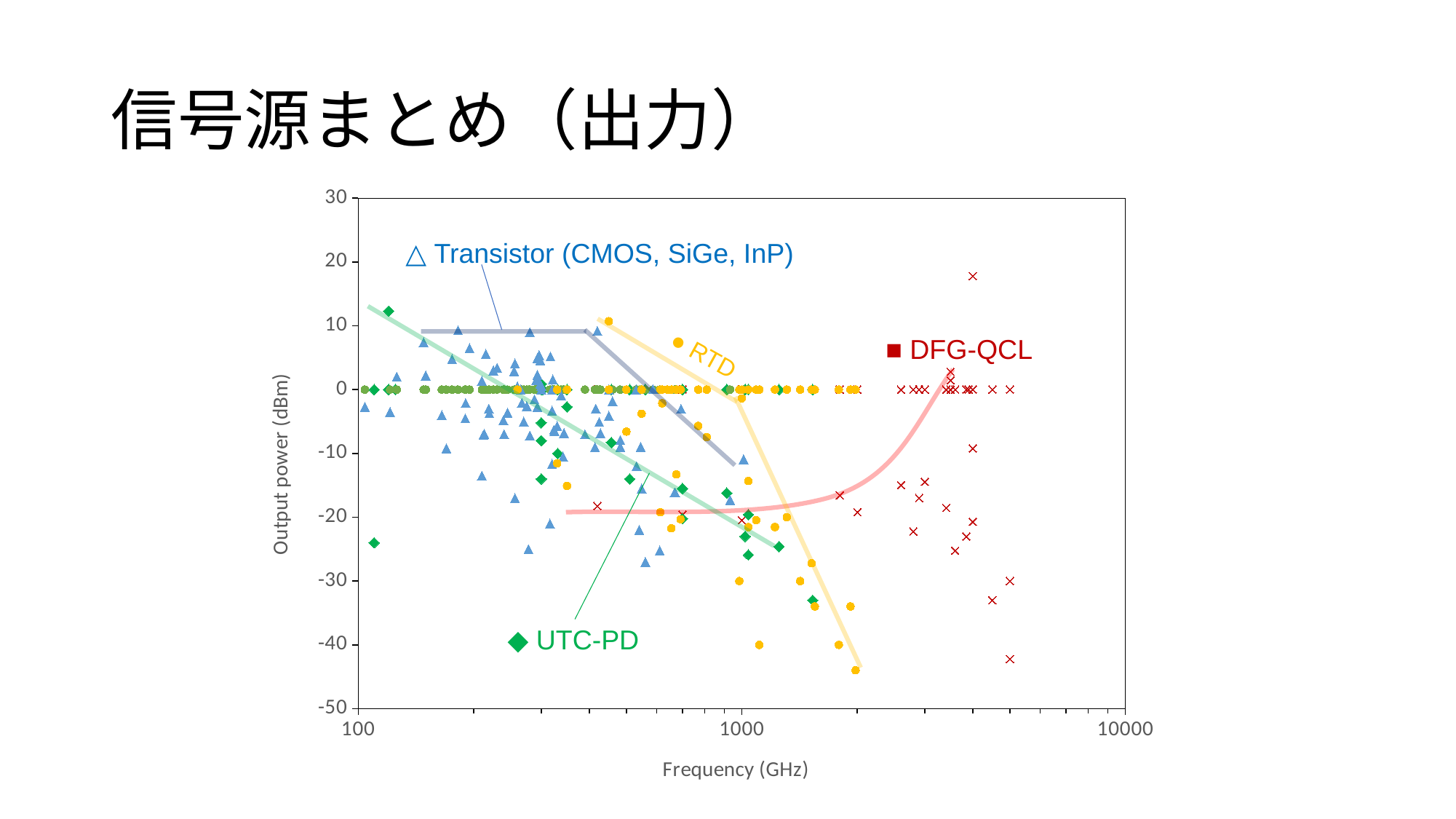
Along the frequency axis, does the output power of the Transistor series generally rise or fall as frequency increases? Fall How many data series are labelled on the chart? 4 What is the title of the vertical axis? Output power (dBm) Which series extends to the highest frequencies on the chart? DFG-QCL Which series contains the point with the lowest output power on the chart? RTD Is the lowest RTD point greater or less than -40 dBm? less What kind of chart is shown on the slide? Scatter chart Is the highest UTC-PD point greater or less than 10 dBm? greater What is the title of the horizontal axis? Frequency (GHz) Which series contains the point with the highest output power on the chart? DFG-QCL Is the highest DFG-QCL point greater or less than 10 dBm? greater